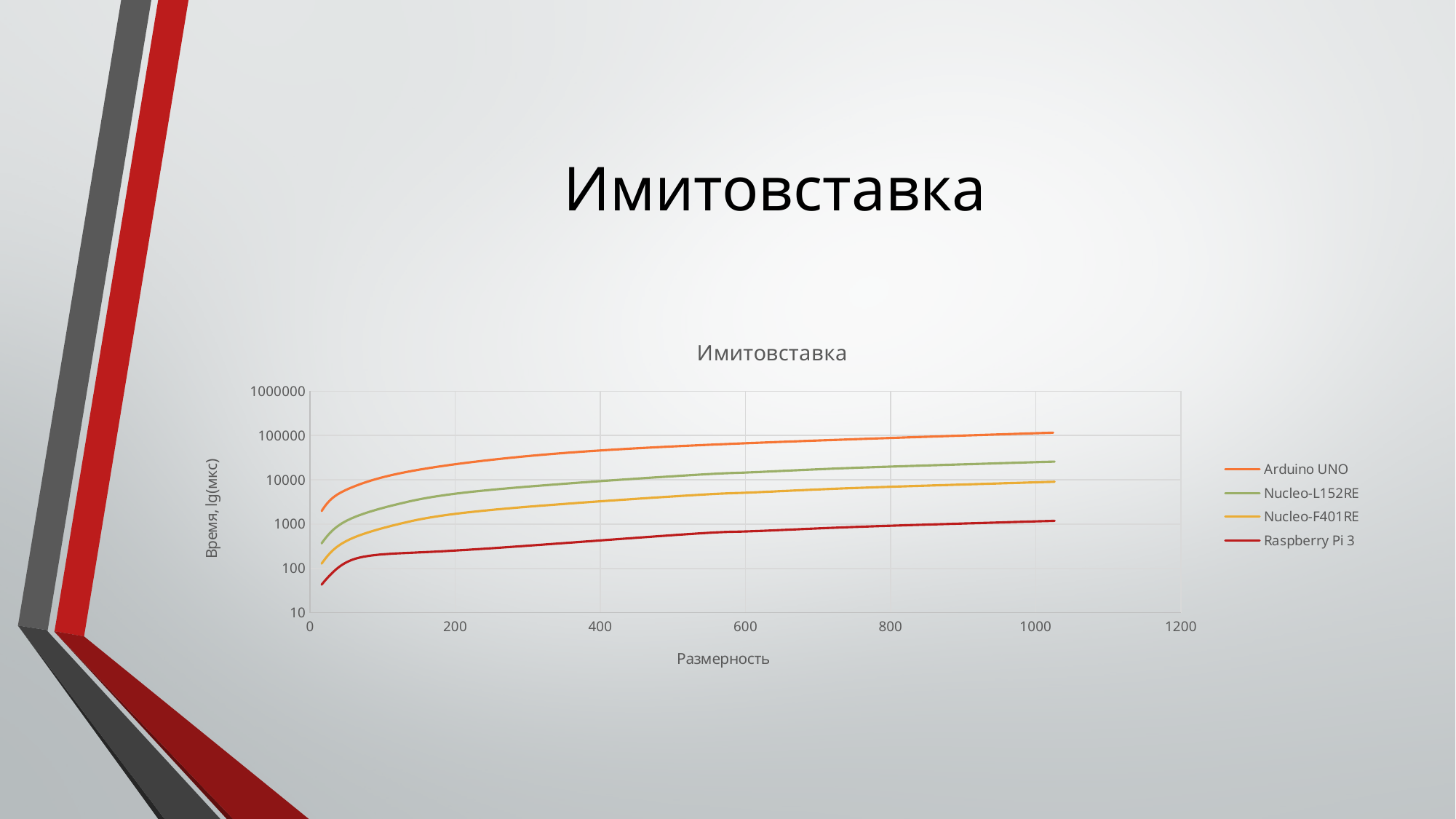
What kind of chart is shown on the slide? line chart Is the value for Arduino UNO at a dimension of 400 greater or less than 10000? greater How many series does the legend list? 4 What is the title of the y axis? Время, lg(мкс) What is the title of the x axis? Размерность At a dimension of 800, which is larger: Nucleo-L152RE or Nucleo-F401RE? Nucleo-L152RE Which series has the lowest values across the chart? Raspberry Pi 3 Is the value for Raspberry Pi 3 at a dimension of 600 greater or less than 1000? less Is the value for Nucleo-F401RE at a dimension of 600 greater or less than 10000? less Do the values of the series rise or fall as the dimension increases along the x axis? rise At a dimension of 600, which is larger: Arduino UNO or Raspberry Pi 3? Arduino UNO Which series has the highest values across the chart? Arduino UNO